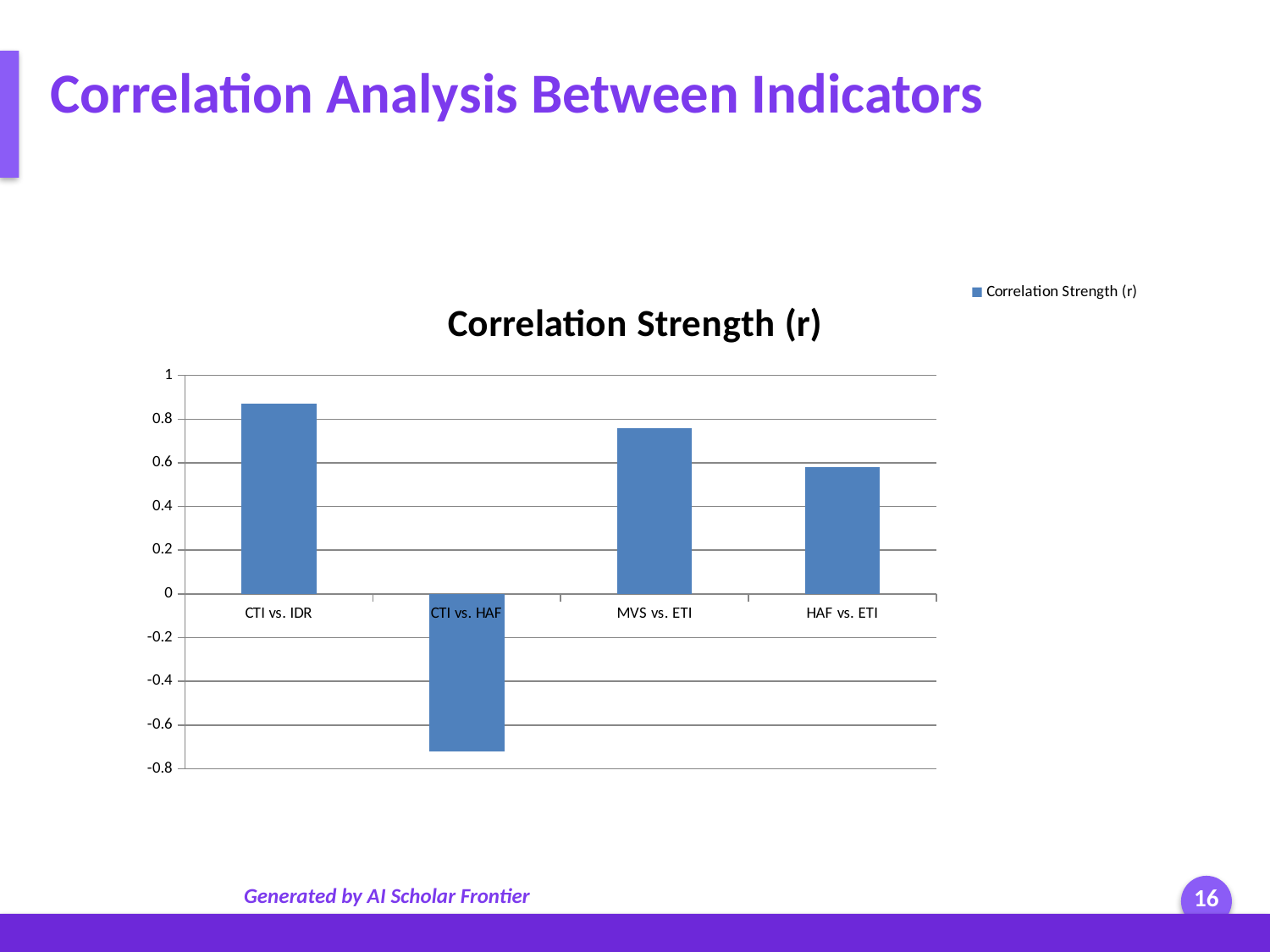
Which is larger, the value for MVS vs. ETI or the value for HAF vs. ETI? MVS vs. ETI What is the title of the chart? Correlation Strength (r) Which category has the highest correlation strength? CTI vs. IDR What kind of chart is shown on the slide? bar chart How many series does the legend list? 1 How many categories are plotted on the x axis? 4 Is the value for CTI vs. HAF greater or less than -0.6? less Is the value for HAF vs. ETI greater or less than 0.4? greater Is the value for MVS vs. ETI greater or less than 0.6? greater Which category is the only one with a negative correlation strength? CTI vs. HAF Which category has the lowest correlation strength? CTI vs. HAF